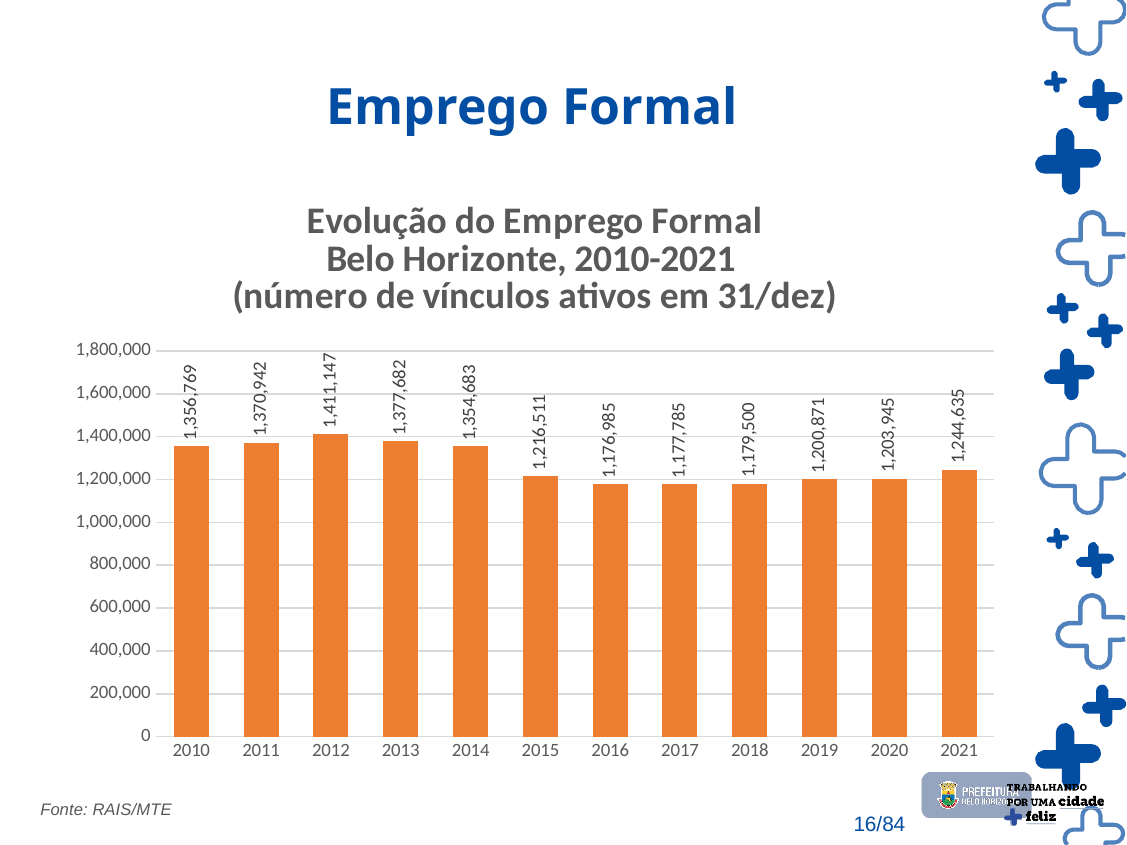
Which is larger, the value for 2010 or the value for 2015? 2010 Is the value for 2018 greater or less than 1,200,000? less What is the value for 2021? 1,244,635 What is the difference between the values for 2012 and 2021? 166,512 How many years are shown on the x axis? 12 What is the difference between the values for 2021 and 2020? 40,690 Which year has the lowest value? 2016 What is the source cited for the chart? RAIS/MTE What kind of chart is this? bar chart What is the value for 2016? 1,176,985 Which year has the highest value? 2012 What is the value for 2012? 1,411,147